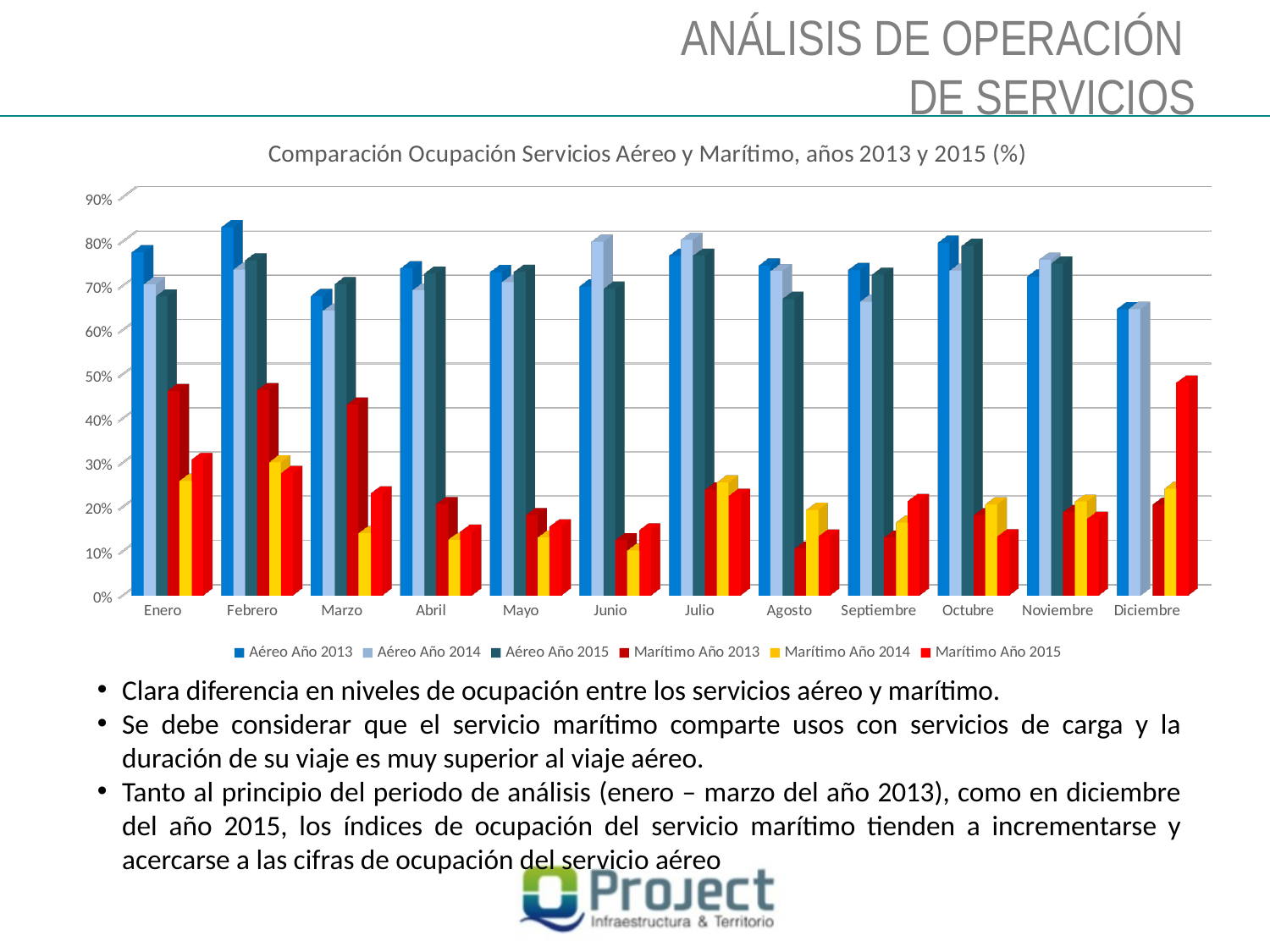
Is the value for Marítimo Año 2015 in Diciembre greater or less than 40%? greater In which month is the Aéreo Año 2013 value highest? Febrero Which is larger for Marítimo Año 2013: the value in Enero or the value in Junio? Enero Is the value for Marítimo Año 2013 in Enero greater or less than 40%? greater How many months (categories) are shown on the x axis of the chart? 12 How many series does the chart legend list? 6 In which month is the Marítimo Año 2015 value highest? Diciembre Which series in the legend is shown in yellow? Marítimo Año 2014 What is the title of the chart? Comparación Ocupación Servicios Aéreo y Marítimo, años 2013 y 2015 (%) Is the value for Aéreo Año 2014 in Marzo greater or less than 70%? less What type of chart is shown on the slide? Bar chart